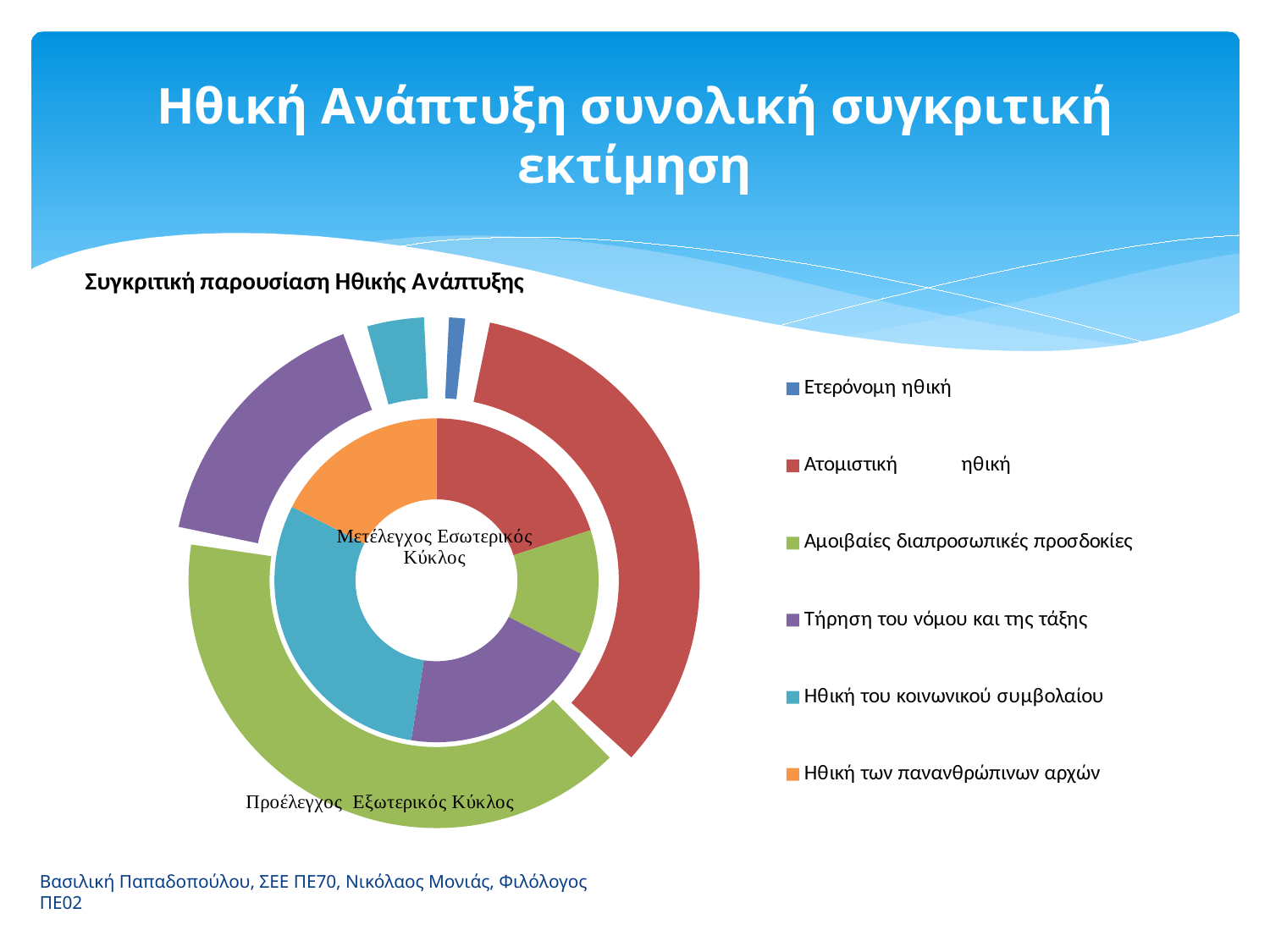
How many categories does the chart legend list? 6 What kind of chart is shown on the slide? Doughnut chart Which category has the largest slice in the inner ring (Μετέλεγχος Εσωτερικός Κύκλος)? Ηθική του κοινωνικού συμβολαίου In the outer ring, which slice is larger: Τήρηση του νόμου και της τάξης or Ηθική του κοινωνικού συμβολαίου? Τήρηση του νόμου και της τάξης How many rings (series) does the doughnut chart have? 2 In the inner ring, which slice is larger: Ατομιστική ηθική or Αμοιβαίες διαπροσωπικές προσδοκίες? Ατομιστική ηθική In the outer ring, which slice is larger: Ατομιστική ηθική or Αμοιβαίες διαπροσωπικές προσδοκίες? Αμοιβαίες διαπροσωπικές προσδοκίες Which category has the largest slice in the outer ring (Προέλεγχος Εξωτερικός Κύκλος)? Αμοιβαίες διαπροσωπικές προσδοκίες Which category has the smallest visible slice in the outer ring (Προέλεγχος Εξωτερικός Κύκλος)? Ετερόνομη ηθική What is the title of the chart? Συγκριτική παρουσίαση Ηθικής Ανάπτυξης Which category is shown in red in the chart legend? Ατομιστική ηθική